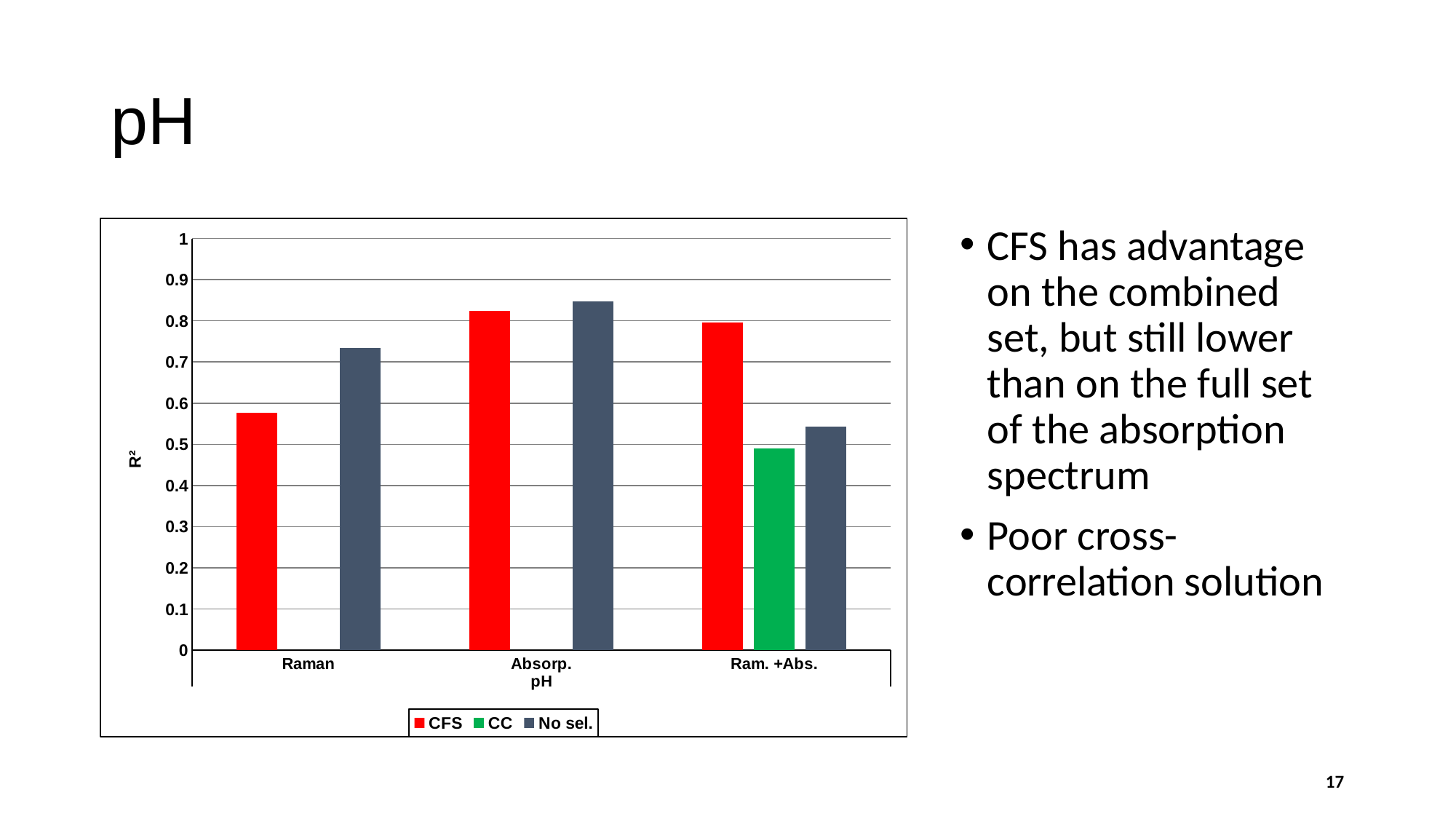
What kind of chart is shown on the slide? bar chart For Raman, which is larger: the CFS bar or the No sel. bar? No sel. Is the CFS value for Raman greater or less than 0.5? greater Is the No sel. value for Raman greater or less than 0.7? greater How many series does the chart's legend list? 3 What is the label of the chart's y axis? R² For Ram. +Abs., which is larger: the CFS bar or the No sel. bar? CFS Which series and category has the highest bar in the chart? No sel. for Absorp. Is the CFS value for Absorp. greater or less than 0.8? greater Which series and category has the lowest bar in the chart? CC for Ram. +Abs. How many categories are shown on the x axis of the chart? 3